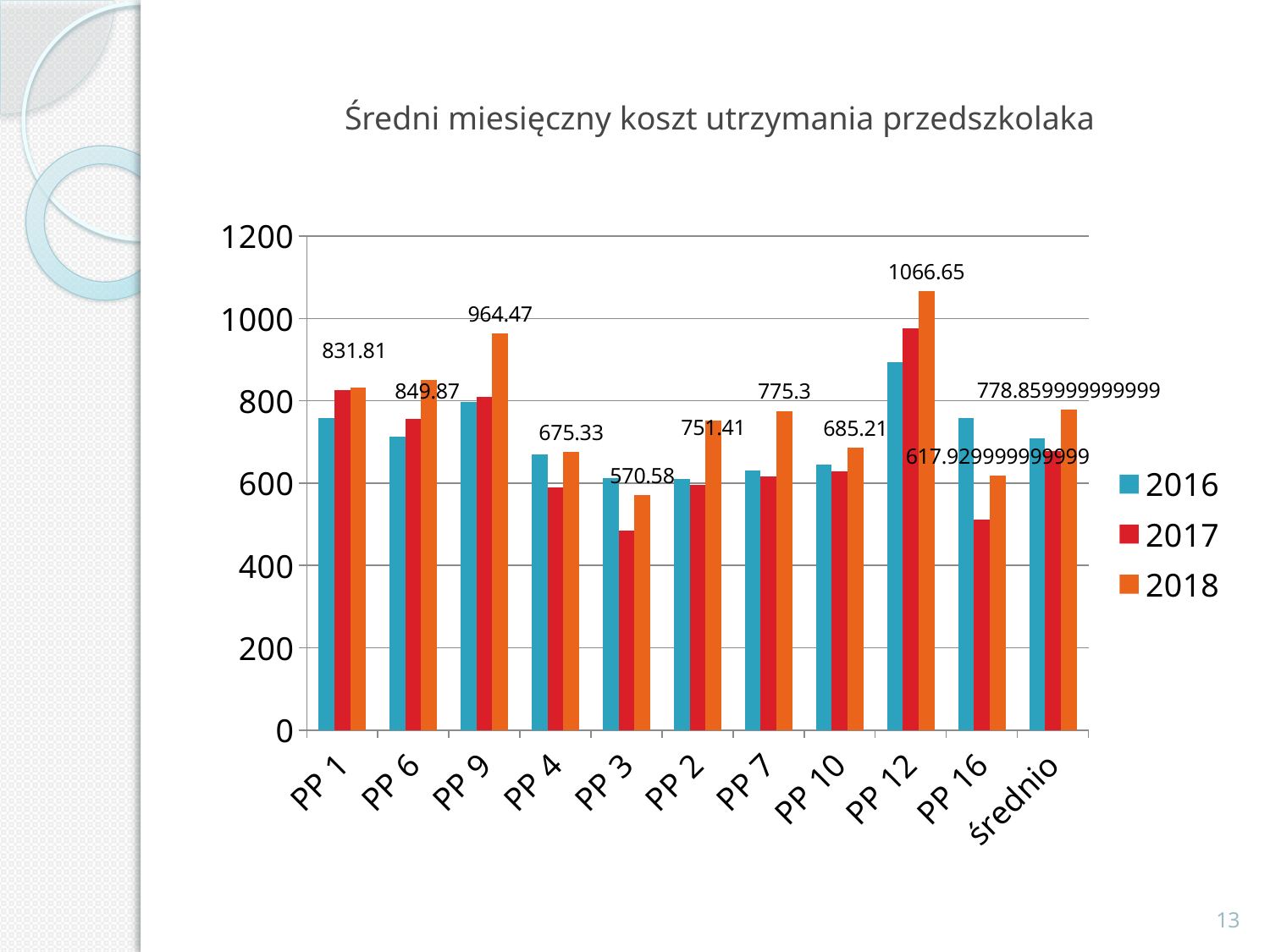
Which has the larger 2018 value, PP 1 or PP 6? PP 6 Which category has the lowest 2018 value? PP 3 Is the 2016 value for PP 12 greater or less than 800? greater What kind of chart is shown on the slide? bar chart Which category has the highest 2018 value? PP 12 What is the difference between the 2018 values for PP 12 and PP 9? 102.18 How many categories are shown on the x axis? 11 Is the 2017 value for PP 16 greater or less than 600? less What is the 2018 value for PP 16 as printed on the chart? 617.929999999999 What is the 2018 value for PP 12? 1066.65 How many series does the legend list? 3 What is the 2018 value for PP 3? 570.58